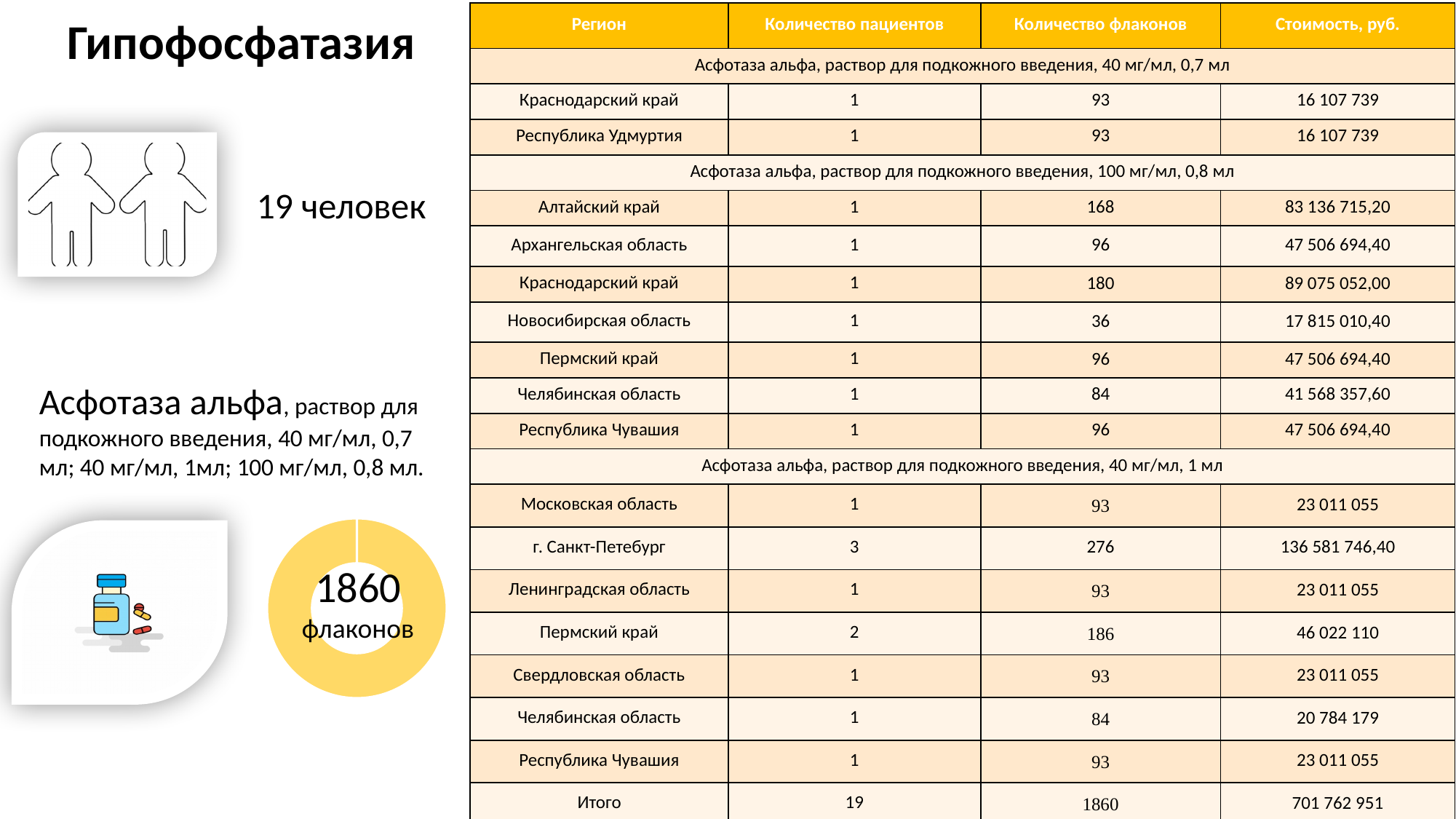
What kind of chart is shown on the left side of the slide below the drug description? pie chart (donut) What number is printed in the centre of the donut chart? 1860 What label appears under the number in the centre of the donut chart? флаконов How many visible slices does the donut chart have? 1 What colour is the ring of the donut chart? yellow